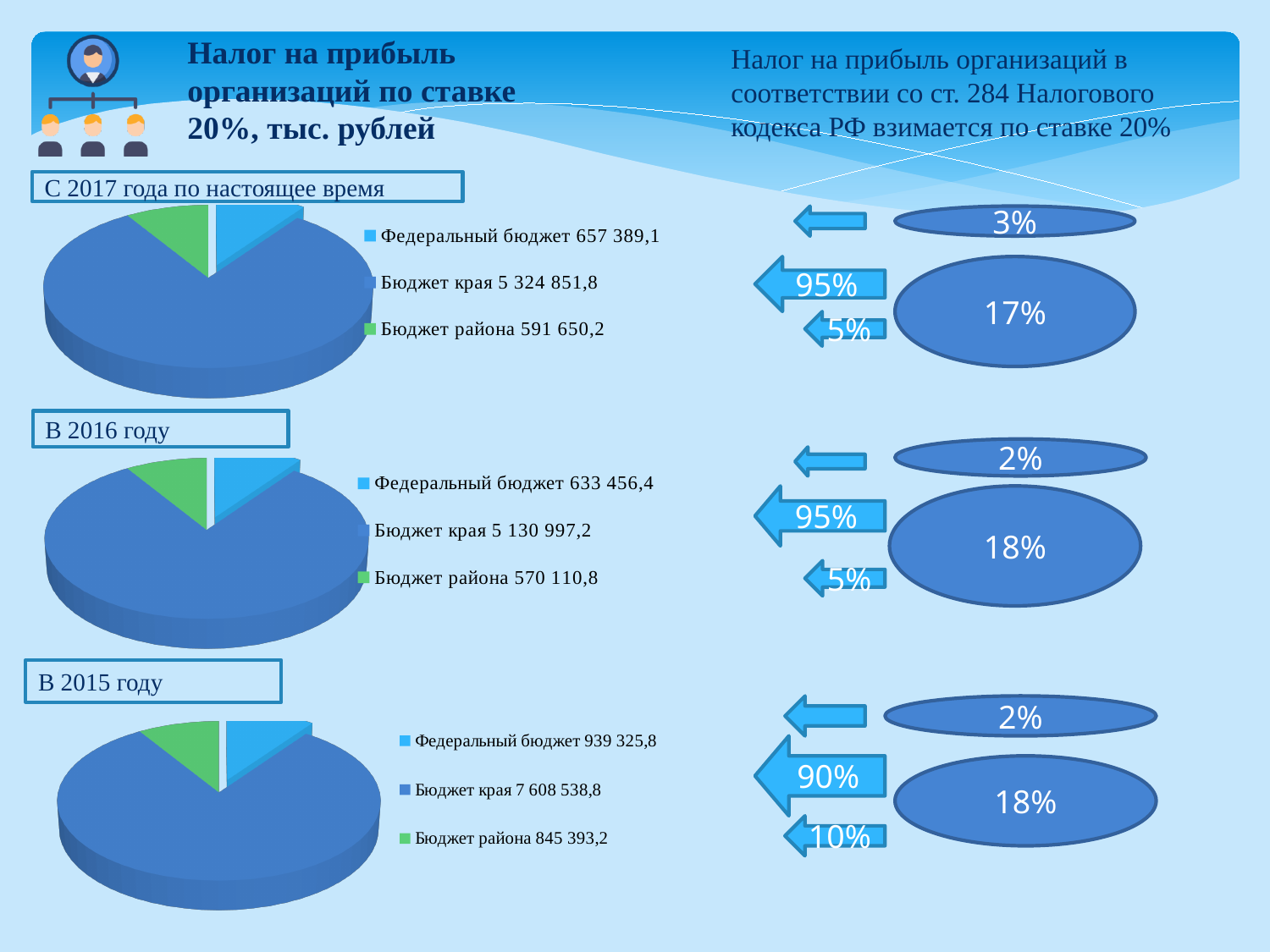
In the chart titled 'В 2016 году', which category has the smallest value? Бюджет района In the chart titled 'В 2015 году', which category has the largest value? Бюджет края How many categories does the chart titled 'В 2015 году' show? 3 What kind of chart is the chart titled 'В 2016 году'? Pie chart In the chart titled 'В 2016 году', what is the value for Бюджет района? 570 110,8 In the chart titled 'С 2017 года по настоящее время', what is the value for Федеральный бюджет? 657 389,1 In the chart titled 'С 2017 года по настоящее время', what is the difference between Федеральный бюджет and Бюджет района? 65 738,9 In the chart titled 'В 2015 году', what is the difference between Федеральный бюджет and Бюджет района? 93 932,6 In the chart titled 'В 2015 году', what is the value for Бюджет края? 7 608 538,8 In the chart titled 'С 2017 года по настоящее время', what colour is the Бюджет района slice? Green In the chart titled 'С 2017 года по настоящее время', what is the value for Бюджет края? 5 324 851,8 In the chart titled 'В 2016 году', which is larger: Федеральный бюджет or Бюджет района? Федеральный бюджет